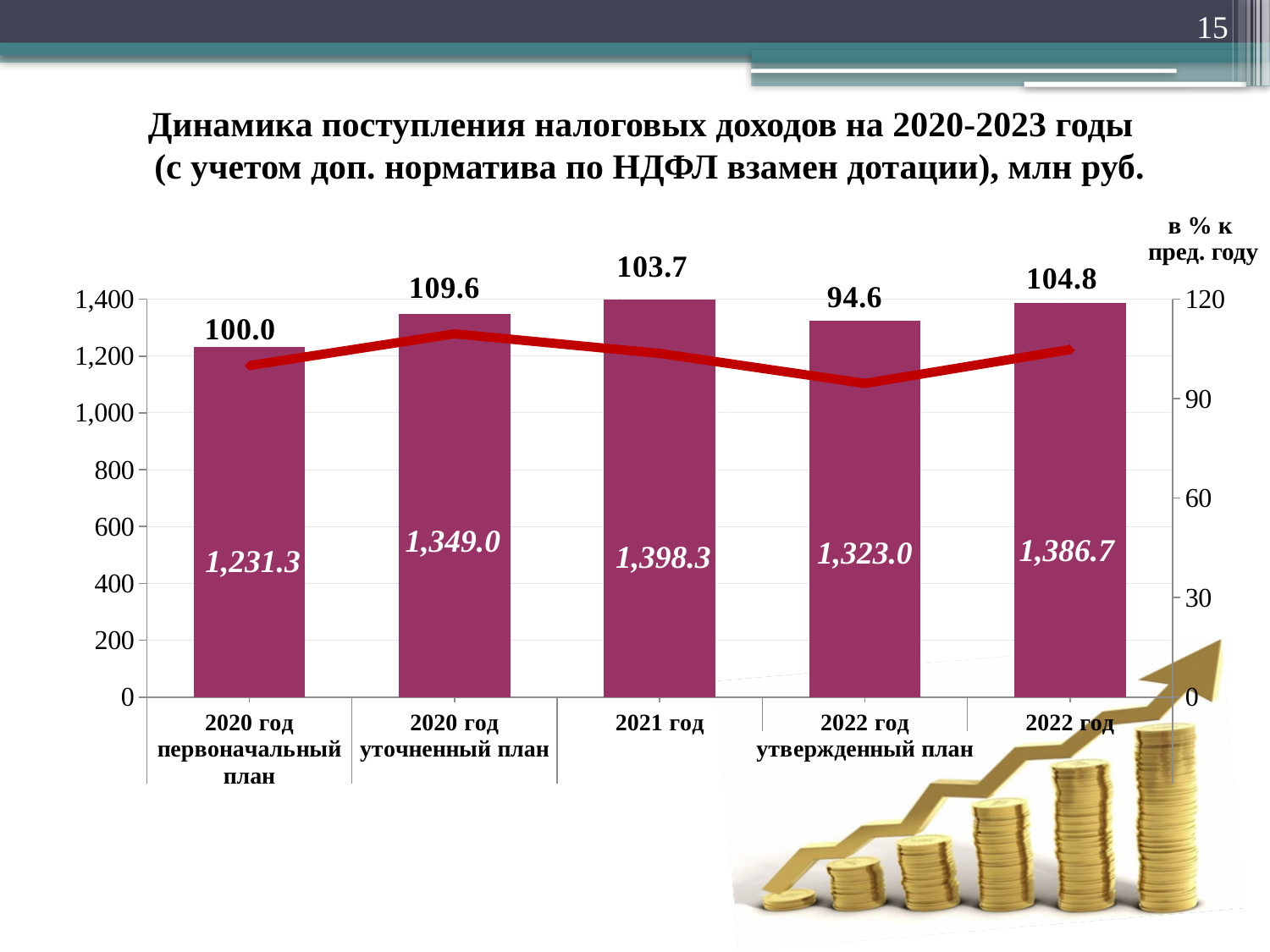
How many bars are plotted in the chart? 5 Which category has the highest bar value? 2021 год Which category has the lowest line value (в % к пред. году)? 2022 год утвержденный план What is the value of the bar for "2020 год первоначальный план"? 1,231.3 Which category has the lowest bar value? 2020 год первоначальный план What kind of chart is shown on the slide? Bar chart with a line What is the line value (в % к пред. году) for "2022 год утвержденный план"? 94.6 What is the value of the bar for "2021 год"? 1,398.3 What is the difference between the bar values for "2021 год" and "2022 год утвержденный план"? 75.3 Which is larger: the bar value for "2020 год уточненный план" or for "2022 год утвержденный план"? 2020 год уточненный план What is the line value (в % к пред. году) for "2020 год уточненный план"? 109.6 What unit is stated in the chart title for the values? млн руб.